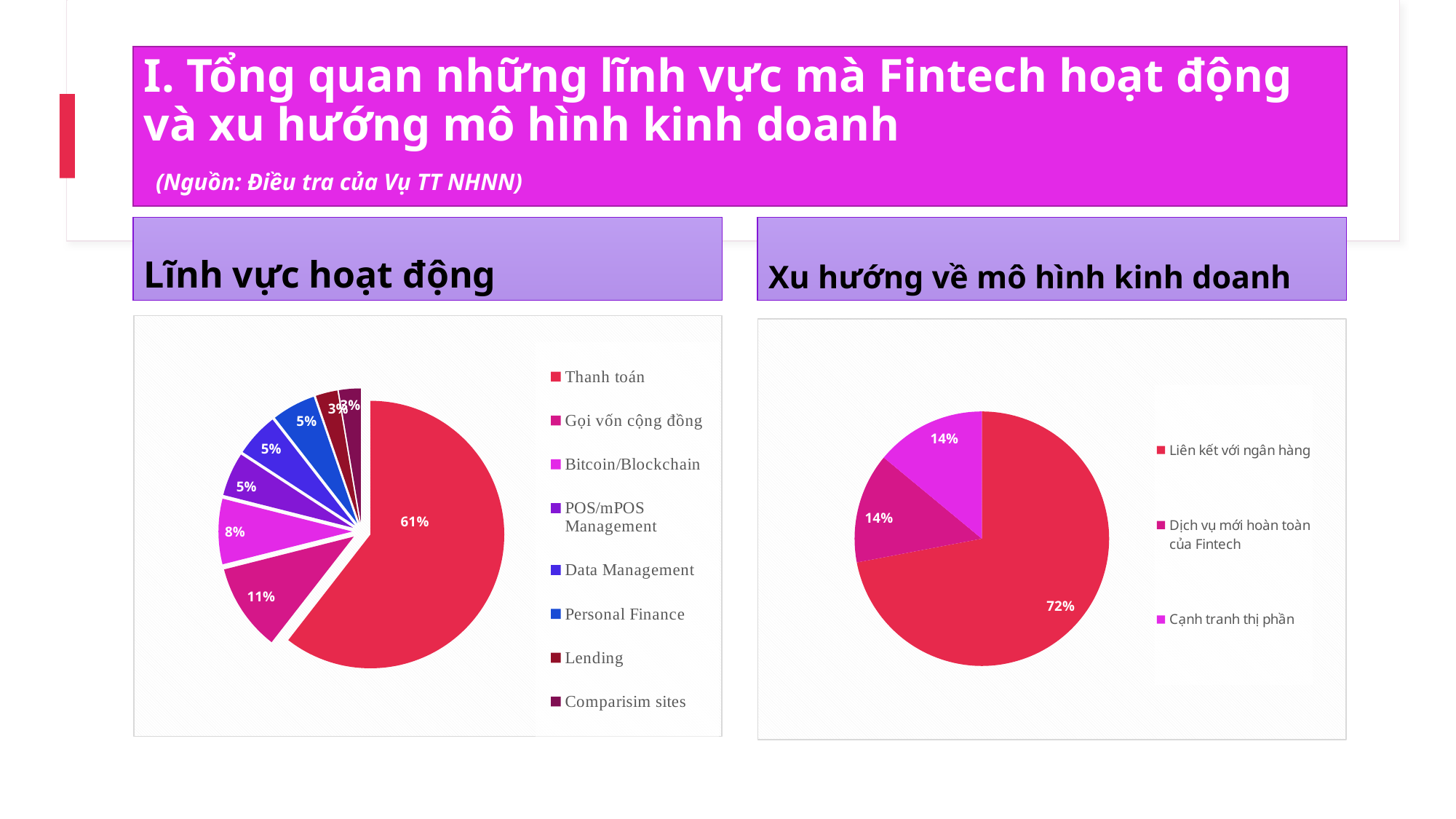
In the left chart (Lĩnh vực hoạt động), what share does Gọi vốn cộng đồng have? 11% In the right chart (Xu hướng về mô hình kinh doanh), what share does Cạnh tranh thị phần have? 14% In the left chart (Lĩnh vực hoạt động), what share does Thanh toán have? 61% In the right chart (Xu hướng về mô hình kinh doanh), what share does Liên kết với ngân hàng have? 72% In the right chart (Xu hướng về mô hình kinh doanh), what is the difference between Liên kết với ngân hàng and Dịch vụ mới hoàn toàn của Fintech? 58% In the left chart (Lĩnh vực hoạt động), what is the difference between the Thanh toán share and the Gọi vốn cộng đồng share? 50% In the left chart (Lĩnh vực hoạt động), which is larger: Gọi vốn cộng đồng or Bitcoin/Blockchain? Gọi vốn cộng đồng What kind of chart is the right chart (Xu hướng về mô hình kinh doanh)? Pie chart In the left chart (Lĩnh vực hoạt động), which category has the largest slice? Thanh toán In the left chart (Lĩnh vực hoạt động), how many categories does the legend list? 8 In the left chart (Lĩnh vực hoạt động), what share does Bitcoin/Blockchain have? 8% In the right chart (Xu hướng về mô hình kinh doanh), how many categories does the legend list? 3